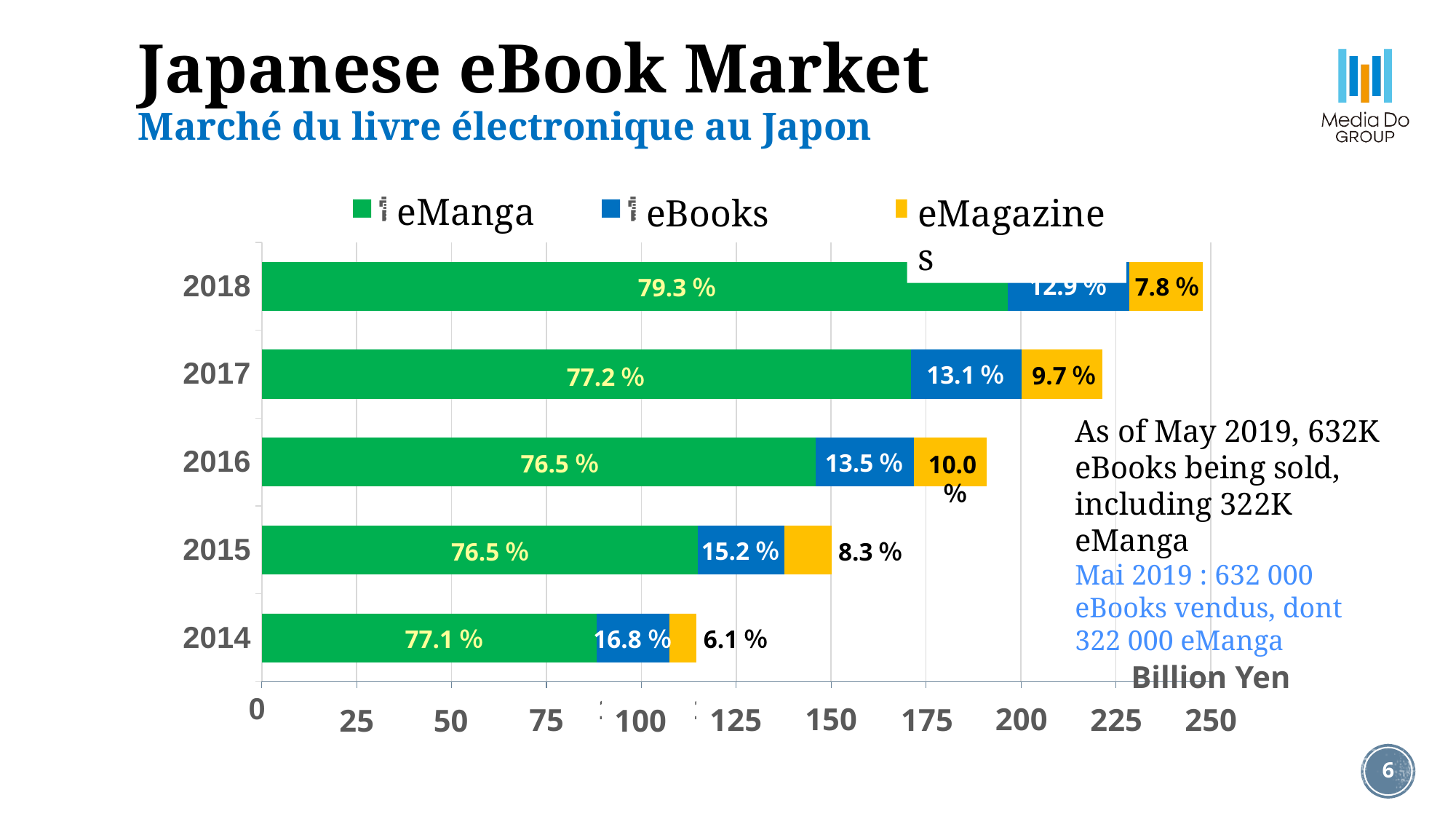
How many series does the legend list? 3 What is the eMagazines share label for 2014? 6.1 % Does the total market size (bar length) rise or fall from 2014 to 2018? Rise Which year has the highest eManga share? 2018 What is the eBooks share label for 2015? 15.2 % Which year has the lowest eMagazines share? 2014 Is the eBooks share larger in 2015 or in 2016? 2015 By how many percentage points does the eManga share in 2018 exceed that in 2017? 2.1 What is the eManga share label for 2018? 79.3 % What kind of chart is shown on the slide? Stacked bar chart How many years are shown on the chart? 5 Is the total bar length for 2018 greater or less than 225 billion yen? greater